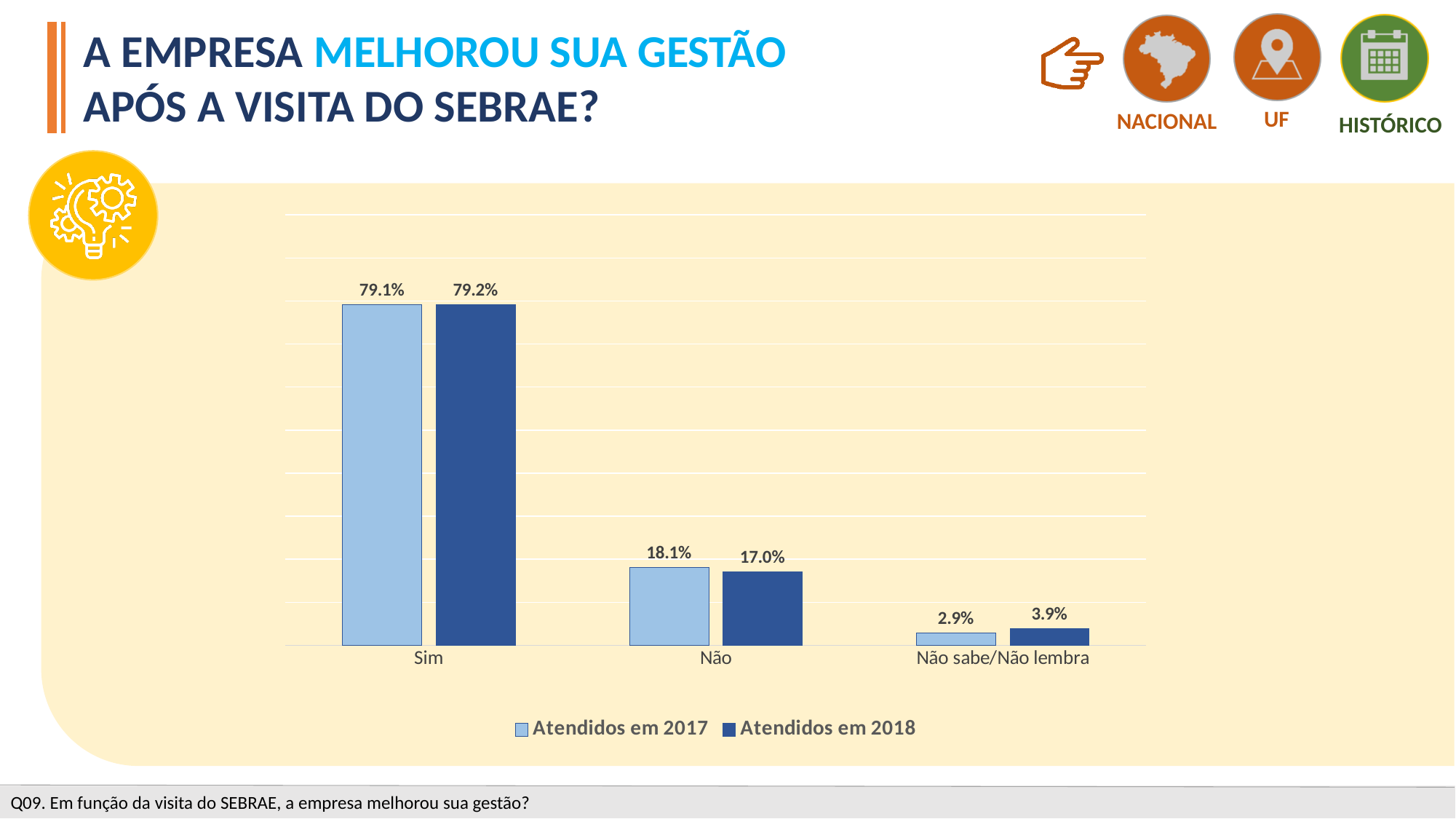
How many series does the legend list? 2 What is the value for "Não sabe/Não lembra" in the "Atendidos em 2018" series? 3.9% Which category has the lowest value in the "Atendidos em 2017" series? Não sabe/Não lembra How many categories are shown on the x axis? 3 What is the value for "Não" in the "Atendidos em 2018" series? 17.0% For "Não sabe/Não lembra", which series has the larger value, "Atendidos em 2017" or "Atendidos em 2018"? Atendidos em 2018 Which category has the highest value in the "Atendidos em 2018" series? Sim Which series is shown in the darker blue colour? Atendidos em 2018 What is the value for "Não sabe/Não lembra" in the "Atendidos em 2017" series? 2.9% What is the difference between the "Atendidos em 2017" and "Atendidos em 2018" values for "Não"? 1.1% What kind of chart is shown on the slide? Bar chart What is the value for "Sim" in the "Atendidos em 2017" series? 79.1%